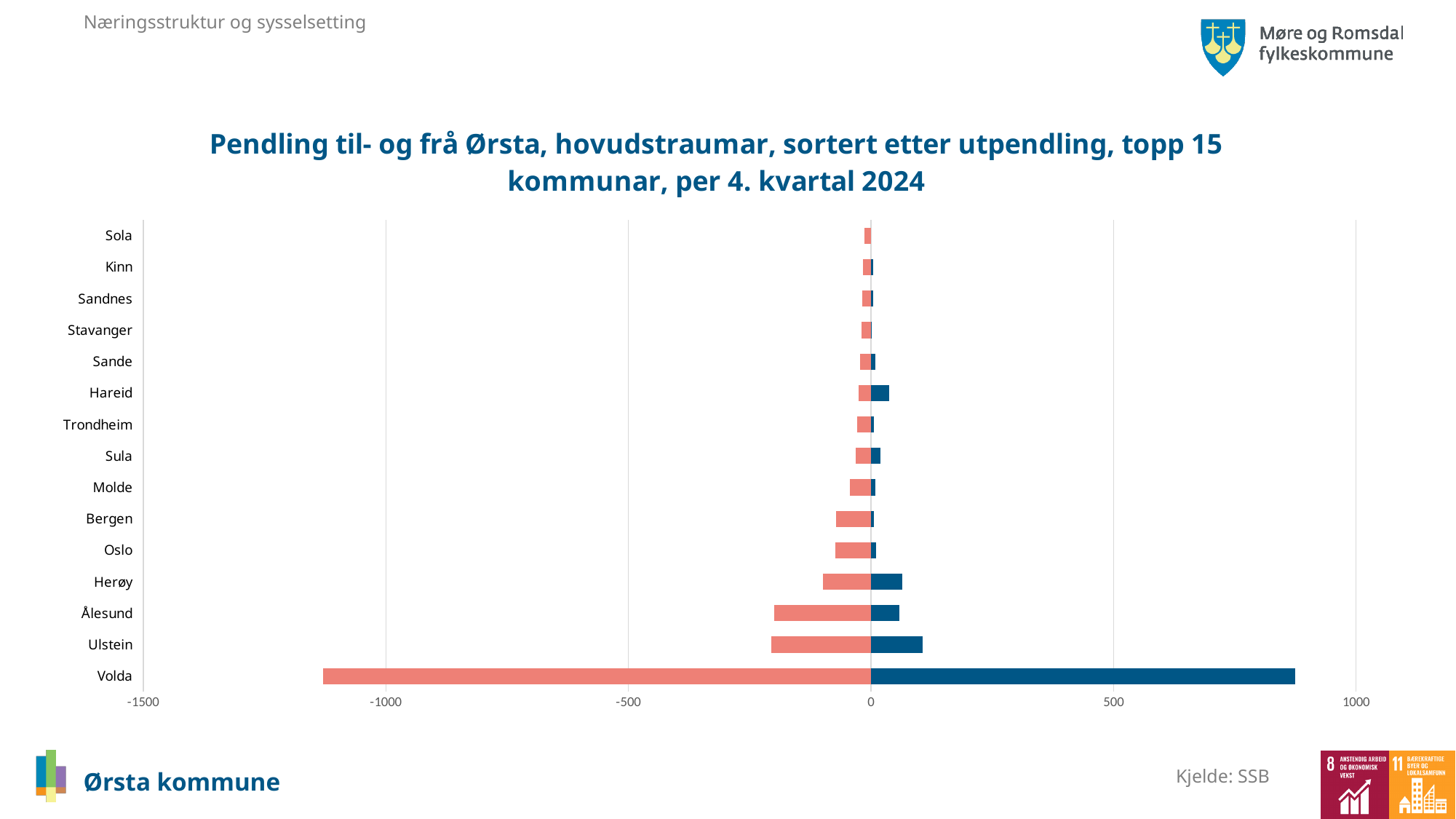
Which municipality is listed at the top of the vertical axis in the chart? Sola Is the blue (positive) value for Volda greater or less than 500? greater Which has the longer red (negative) bar, Ålesund or Herøy? Ålesund How many municipalities (categories) are listed on the vertical axis of the chart? 15 What is the lowest value shown on the horizontal axis of the chart? -1500 Is the blue (positive) value for Ålesund greater or less than 500? less Is the red (negative) value for Ulstein greater or less than -500? greater Which has the longer blue (positive) bar, Ulstein or Hareid? Ulstein What kind of chart is shown on the slide? bar chart Which municipality has the longest blue (positive) bar in the chart? Volda Which municipality has the longest red (negative) bar in the chart? Volda